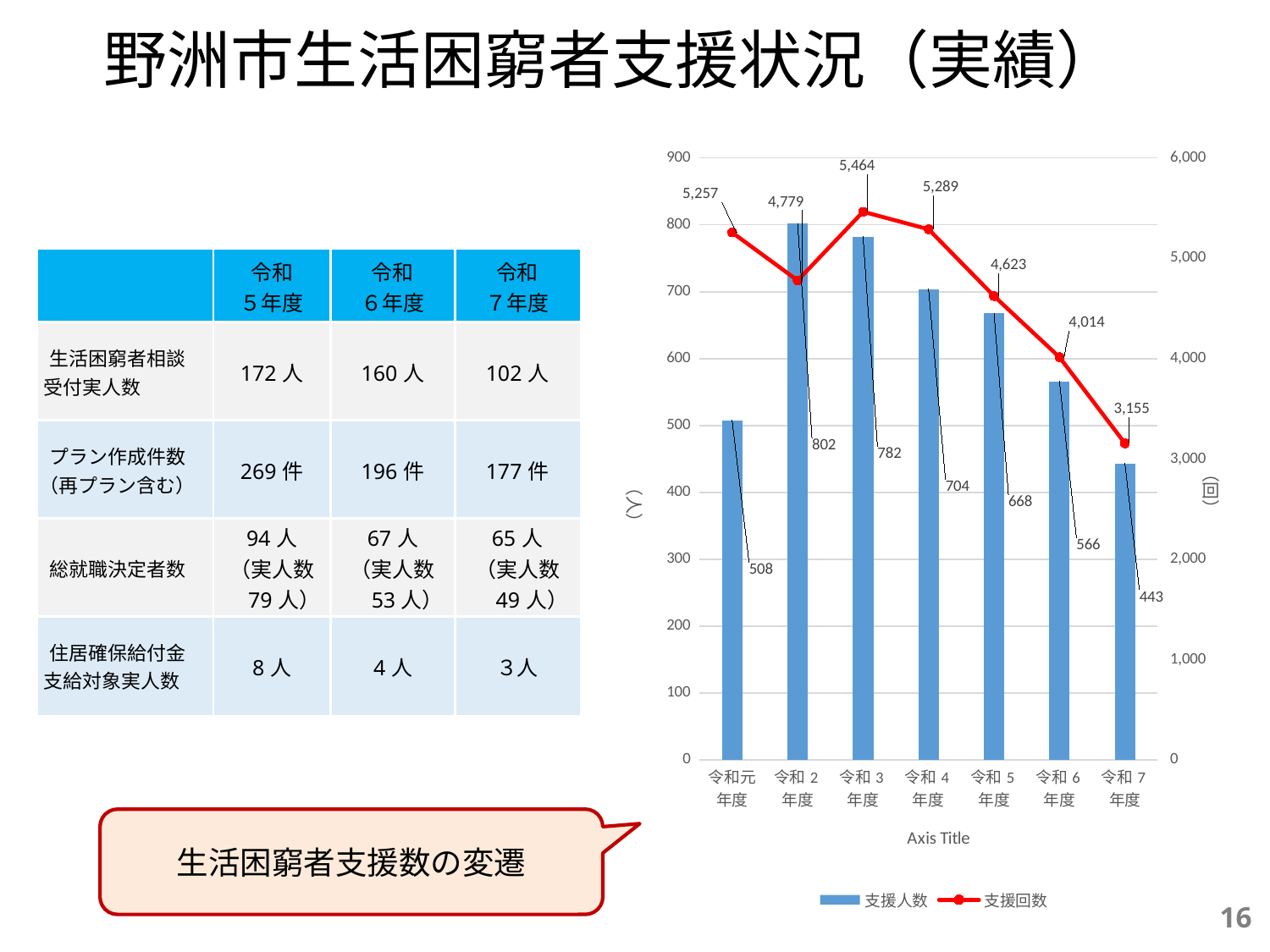
What colour is the 支援回数 line in the chart? red How many years are shown on the x axis of the chart? 7 What is the 支援人数 value for 令和7年度? 443 What is the difference in 支援人数 between 令和2年度 and 令和元年度? 294 What is the 支援回数 value for 令和3年度? 5,464 What is the difference in 支援回数 between 令和4年度 and 令和5年度? 666 Which is larger, the 支援人数 for 令和4年度 or for 令和5年度? 令和4年度 Does the 支援回数 line rise or fall from 令和3年度 to 令和7年度? fall Which year has the lowest 支援人数? 令和7年度 How many series does the chart legend list? 2 Which year has the highest 支援回数? 令和3年度 What is the 支援人数 value for 令和2年度? 802